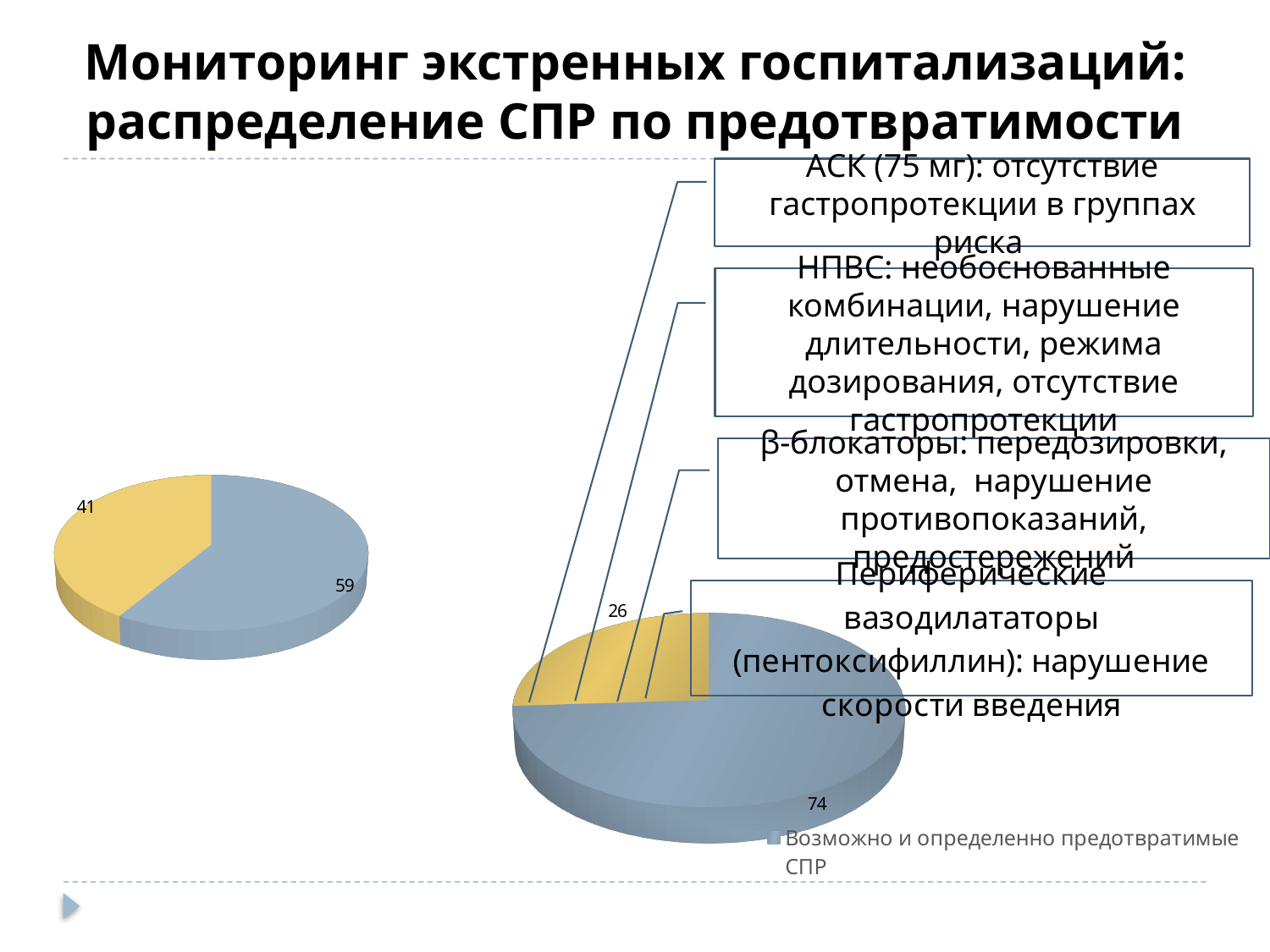
In the left pie chart, what is the difference between the blue slice and the yellow slice? 18 In the right pie chart, what is the difference between the blue slice and the yellow slice? 48 Which legend entry is shown for the blue slice of the right pie chart? Возможно и определенно предотвратимые СПР In the right pie chart, what is the value of the yellow slice? 26 In the left pie chart, what is the value of the blue slice? 59 In the right pie chart, which slice is the largest? the blue slice (74) In the left pie chart, what is the value of the yellow slice? 41 In the right pie chart, what is the value of the blue slice? 74 In the left pie chart, which slice is the smallest? the yellow slice (41) What kind of chart is the right chart on the slide? pie chart What kind of chart is the left chart on the slide? pie chart How many slices does the right pie chart have? 2